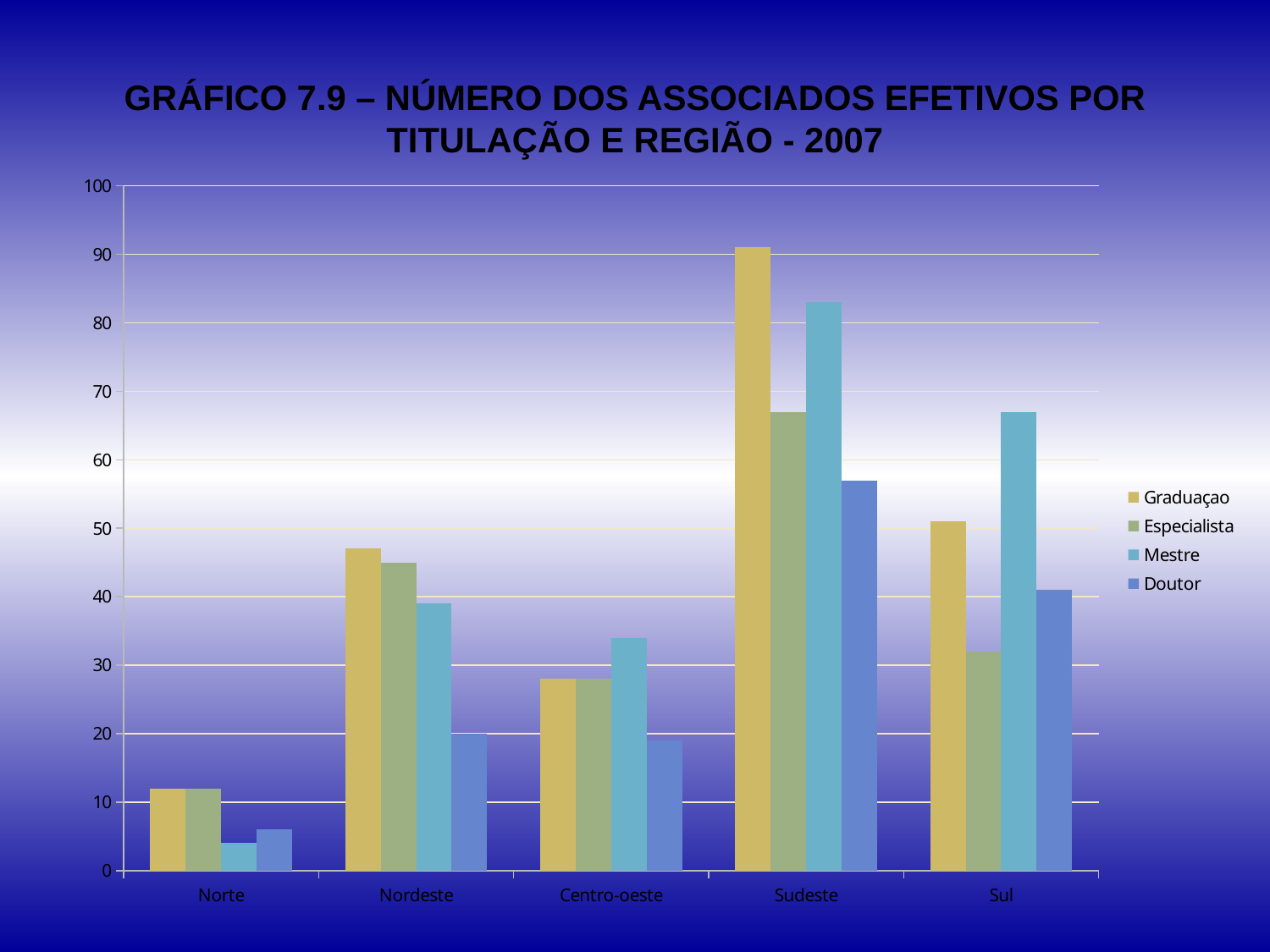
Which series is shown in the yellow bars? Graduaçao Which is larger for Nordeste: the Mestre value or the Doutor value? Mestre Which is larger for Sul: the Graduaçao value or the Mestre value? Mestre How many series does the legend list? 4 Which region has the highest Graduaçao value? Sudeste What year does the chart title refer to? 2007 How many regions are shown on the x axis? 5 Is the Mestre value for Sul greater or less than 60? greater What kind of chart is shown on the slide? bar chart Which region has the lowest Mestre value? Norte